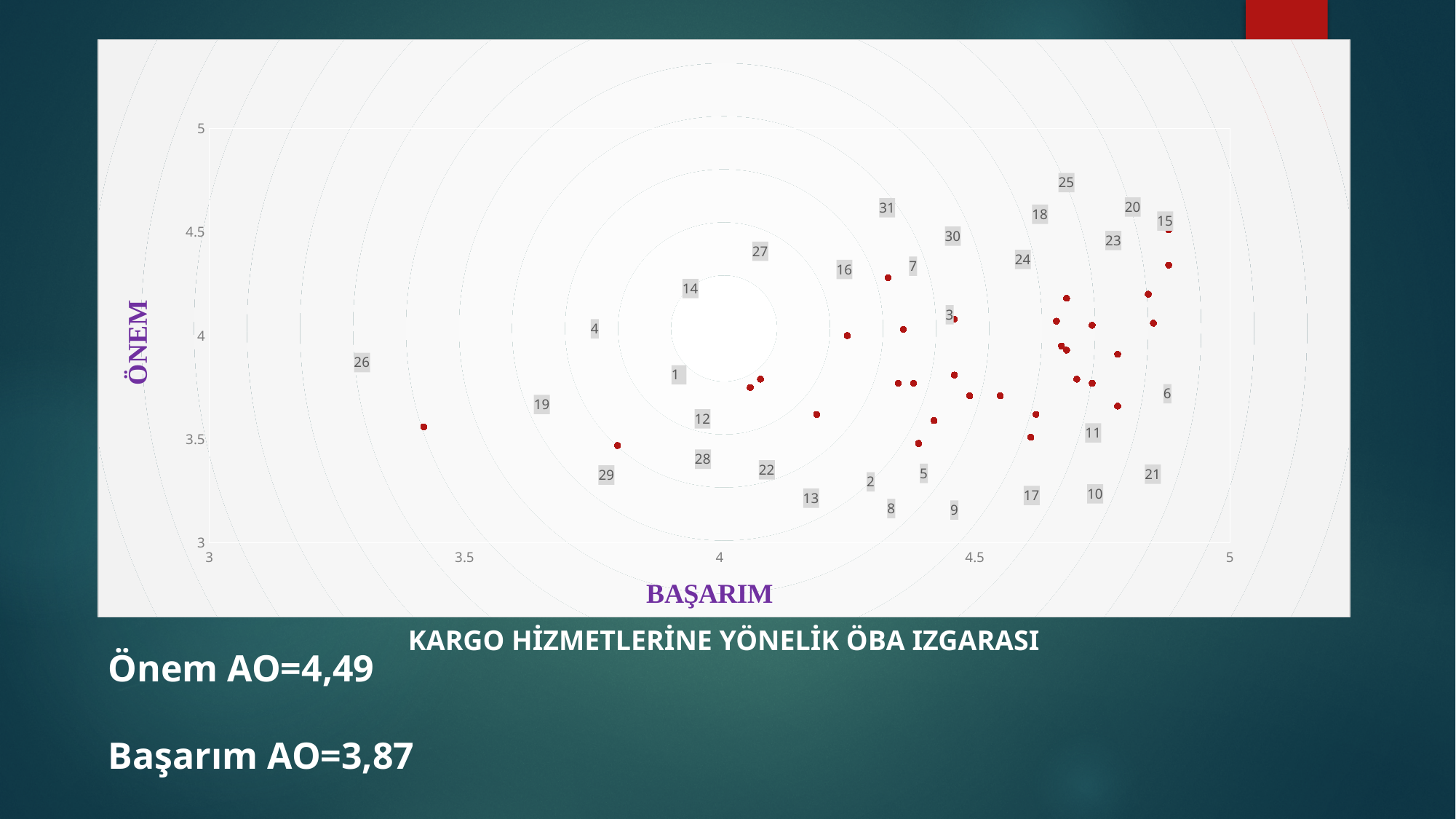
Which is larger, the Önem AO or the Başarım AO? Önem AO What is the label of the horizontal axis of the chart? BAŞARIM What is the title of the chart? KARGO HİZMETLERİNE YÖNELİK ÖBA IZGARASI How many numbered data points are labelled on the chart? 31 What is the label of the vertical axis of the chart? ÖNEM What is the Başarım AO value stated below the chart? 3,87 What is the Önem AO value stated below the chart? 4,49 What kind of chart is shown on the slide? scatter chart